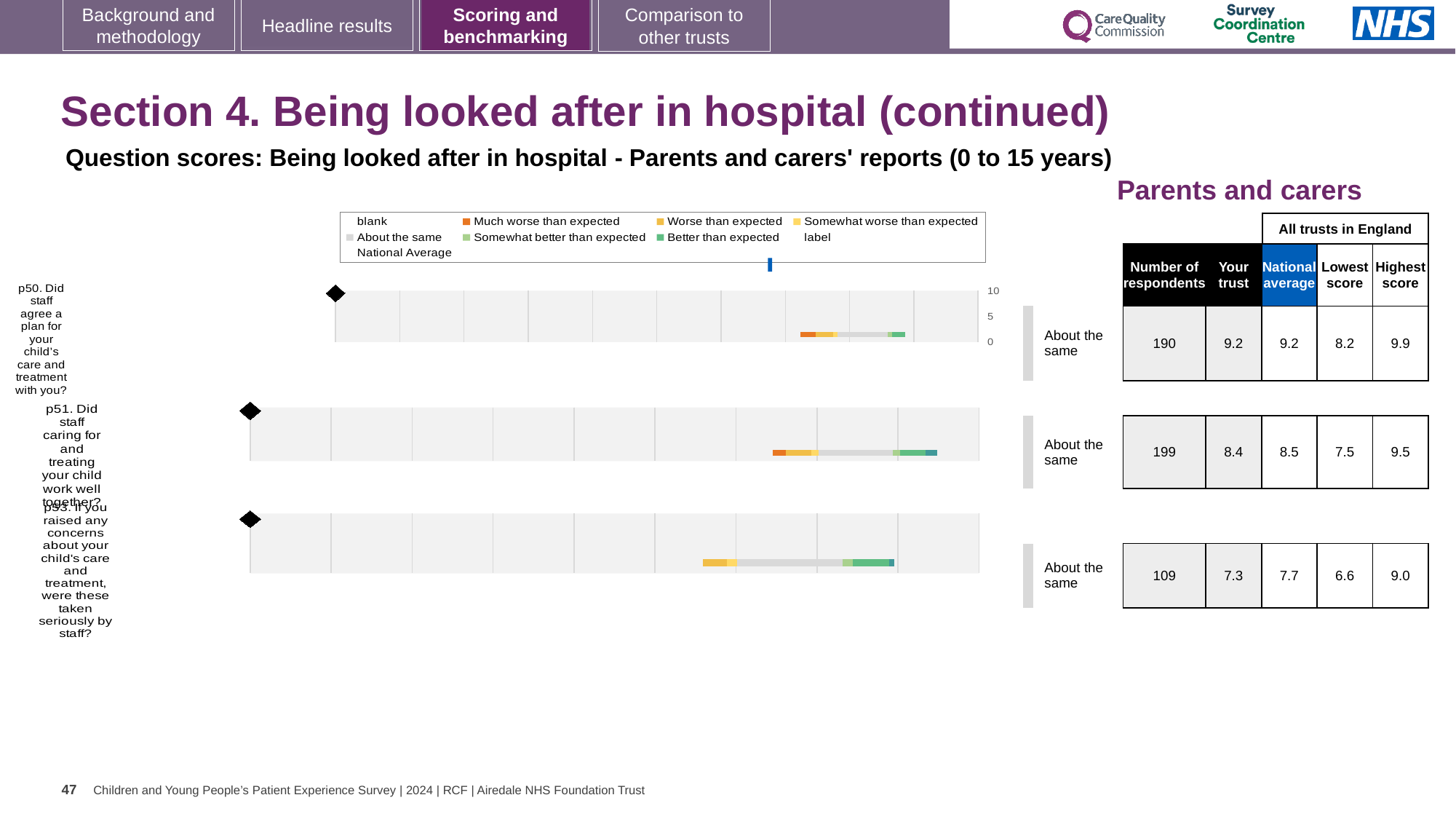
How many survey questions are plotted on this slide? 3 What is the difference between the national average and the 'Your trust' score for p53? 0.4 What is the difference between the highest score and the lowest score for p51? 2.0 What kind of chart is used to show the question scores on this slide? bar chart For p51, which is larger: the 'Your trust' score or the national average? National average What benchmark category is shown for p50? About the same What is the 'Your trust' score for p50 (Did staff agree a plan for your child's care and treatment with you?)? 9.2 What is the national average score for p53 (If you raised any concerns about your child's care and treatment, were these taken seriously by staff?)? 7.7 Which legend entry is shown in orange? Much worse than expected Which question has the highest 'Your trust' score on this slide? p50 Which question has the lowest 'Your trust' score on this slide? p53 How many respondents answered p51 (Did staff caring for and treating your child work well together?)? 199